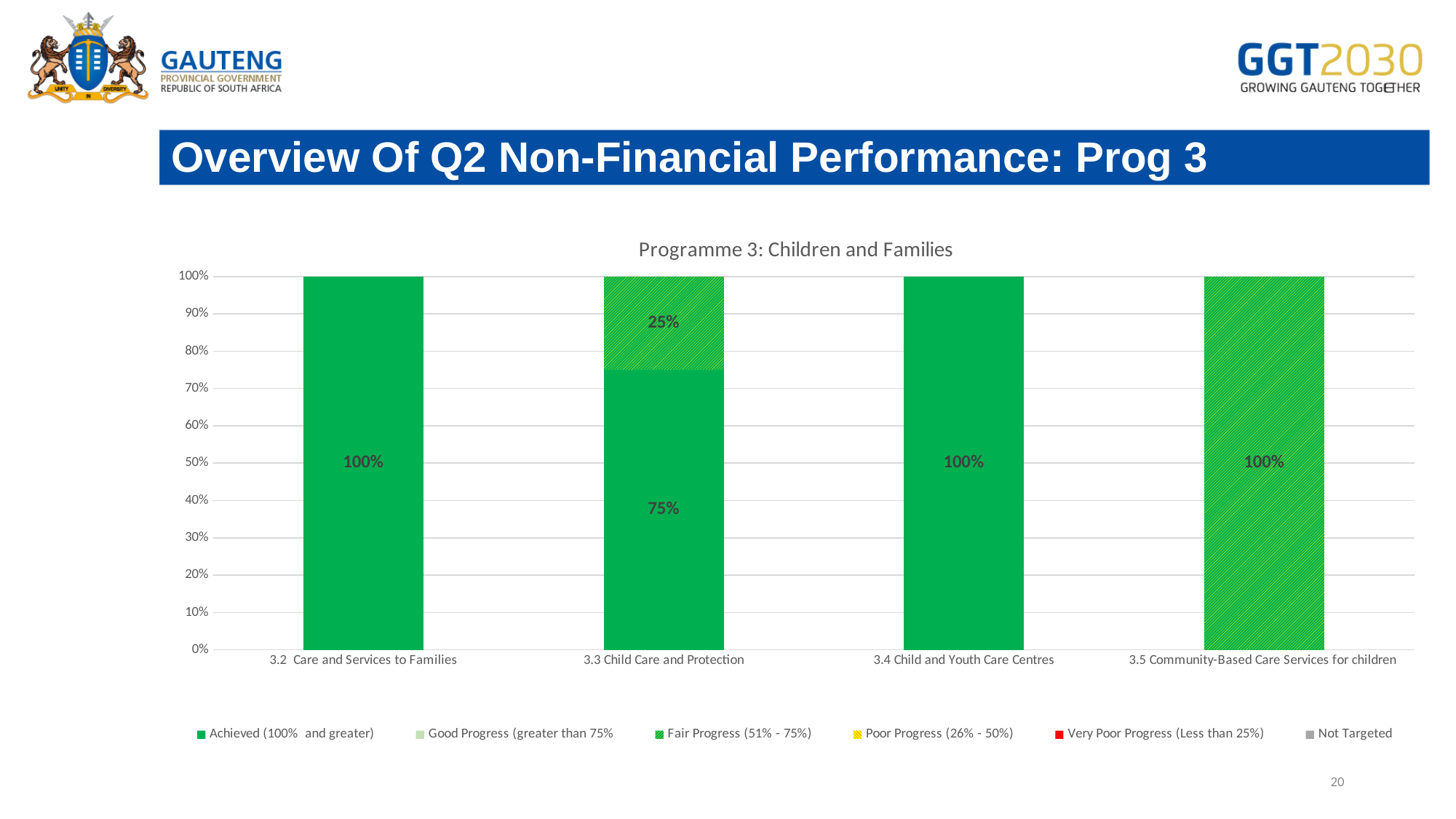
What is the value of the solid green 'Achieved' segment for 3.3 Child Care and Protection? 75% What value is labelled on the bar for 3.4 Child and Youth Care Centres? 100% What is the total of the stacked bar for 3.3 Child Care and Protection? 100% What value is labelled on the bar for 3.5 Community-Based Care Services for children? 100% How many categories are shown on the x axis of the chart? 4 What is the title of the chart? Programme 3: Children and Families What is the difference between the two segments of the 3.3 Child Care and Protection bar? 50% How many series does the chart's legend list? 6 What kind of chart is shown on the slide? Stacked bar chart What value is labelled on the bar for 3.2 Care and Services to Families? 100% Which category is the only one whose bar is split into two segments? 3.3 Child Care and Protection What is the value of the upper (hatched) segment for 3.3 Child Care and Protection? 25%